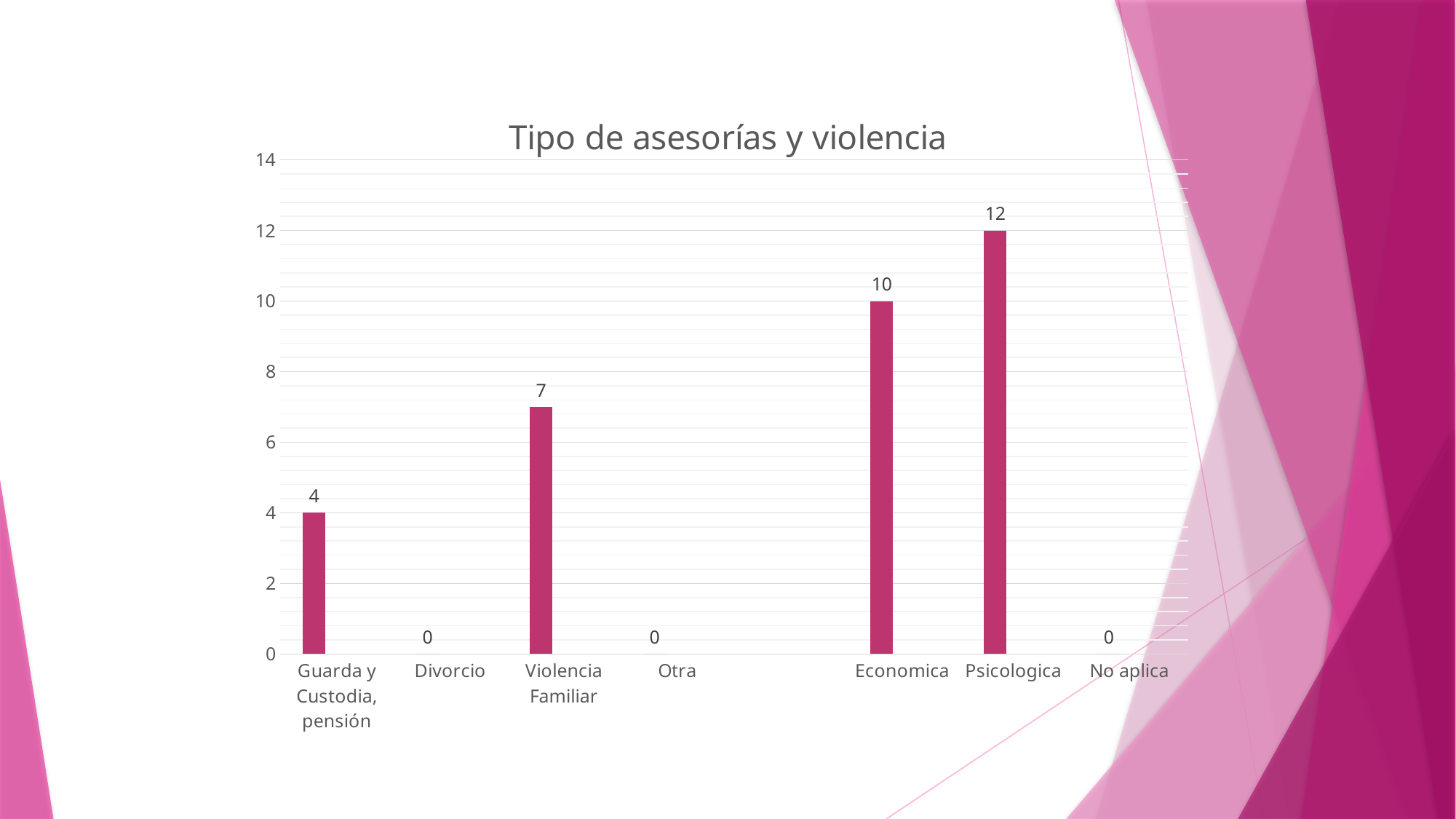
What is the difference between the values for Psicologica and Economica? 2 Which is larger, the value for Economica or the value for Violencia Familiar? Economica What is the difference between the values for Violencia Familiar and Guarda y Custodia, pensión? 3 Which category has the highest value? Psicologica What is the value for Economica? 10 What is the value for Guarda y Custodia, pensión? 4 What is the value for Divorcio? 0 What is the value for Psicologica? 12 Is the value for Psicologica greater or less than 10? greater What is the title of the chart? Tipo de asesorías y violencia What type of chart is shown on the slide? bar chart What is the value for Violencia Familiar? 7